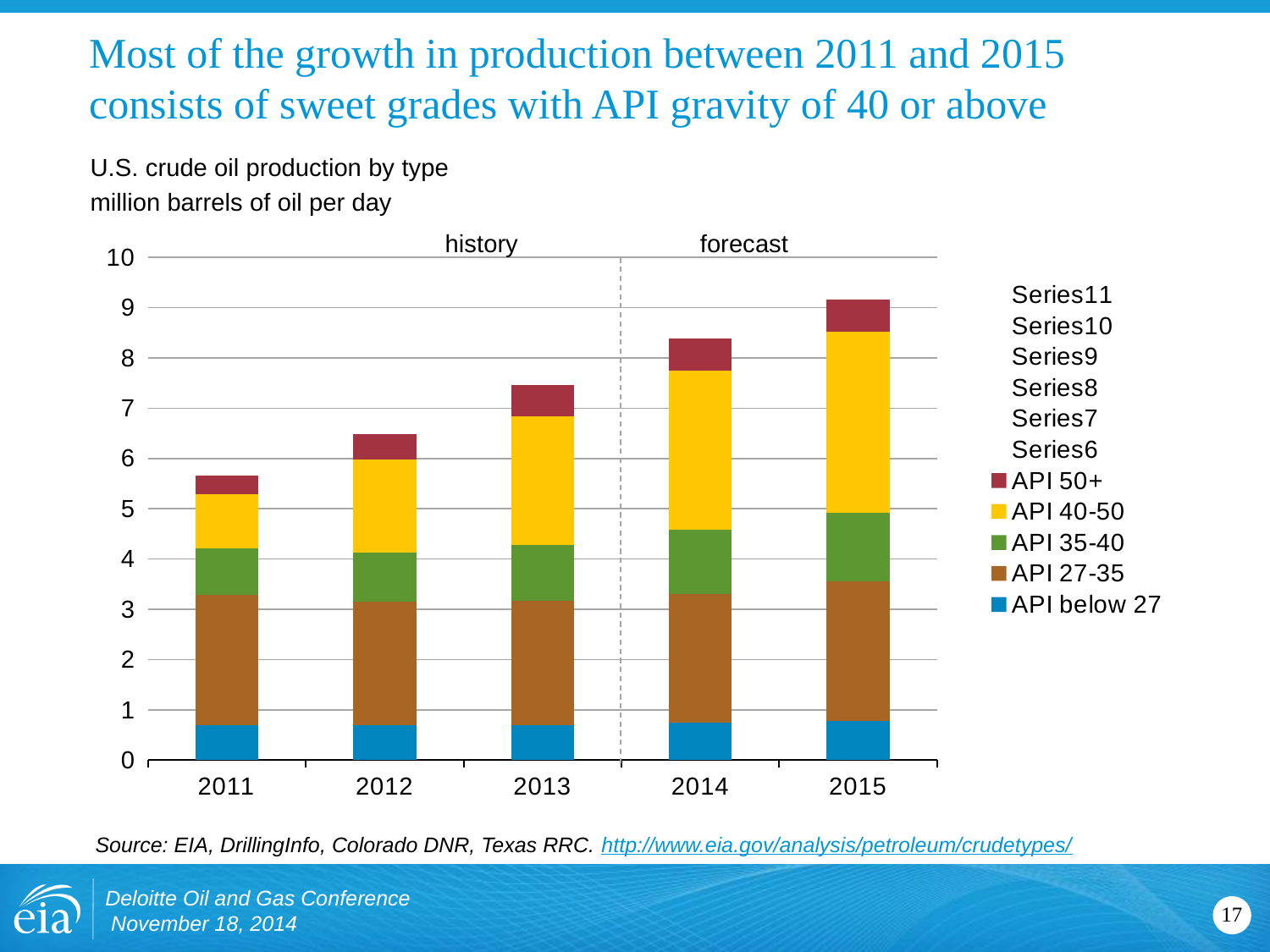
Which is larger, the total production in 2012 or in 2014? 2014 Which years fall in the forecast portion of the chart? 2014 and 2015 Is the total production for 2011 greater or less than 6 million barrels per day? less What kind of chart is shown on the slide? stacked bar chart How many entries does the chart's legend list? 11 Is the total production for 2014 greater or less than 8 million barrels per day? greater Do total crude oil production values rise or fall from 2011 to 2015? rise What unit is the chart's y axis measured in? million barrels of oil per day Which year has the highest total crude oil production in the chart? 2015 Is the total production for 2013 greater or less than 7 million barrels per day? greater How many years are shown on the x axis of the chart? 5 Which year has the lowest total crude oil production in the chart? 2011